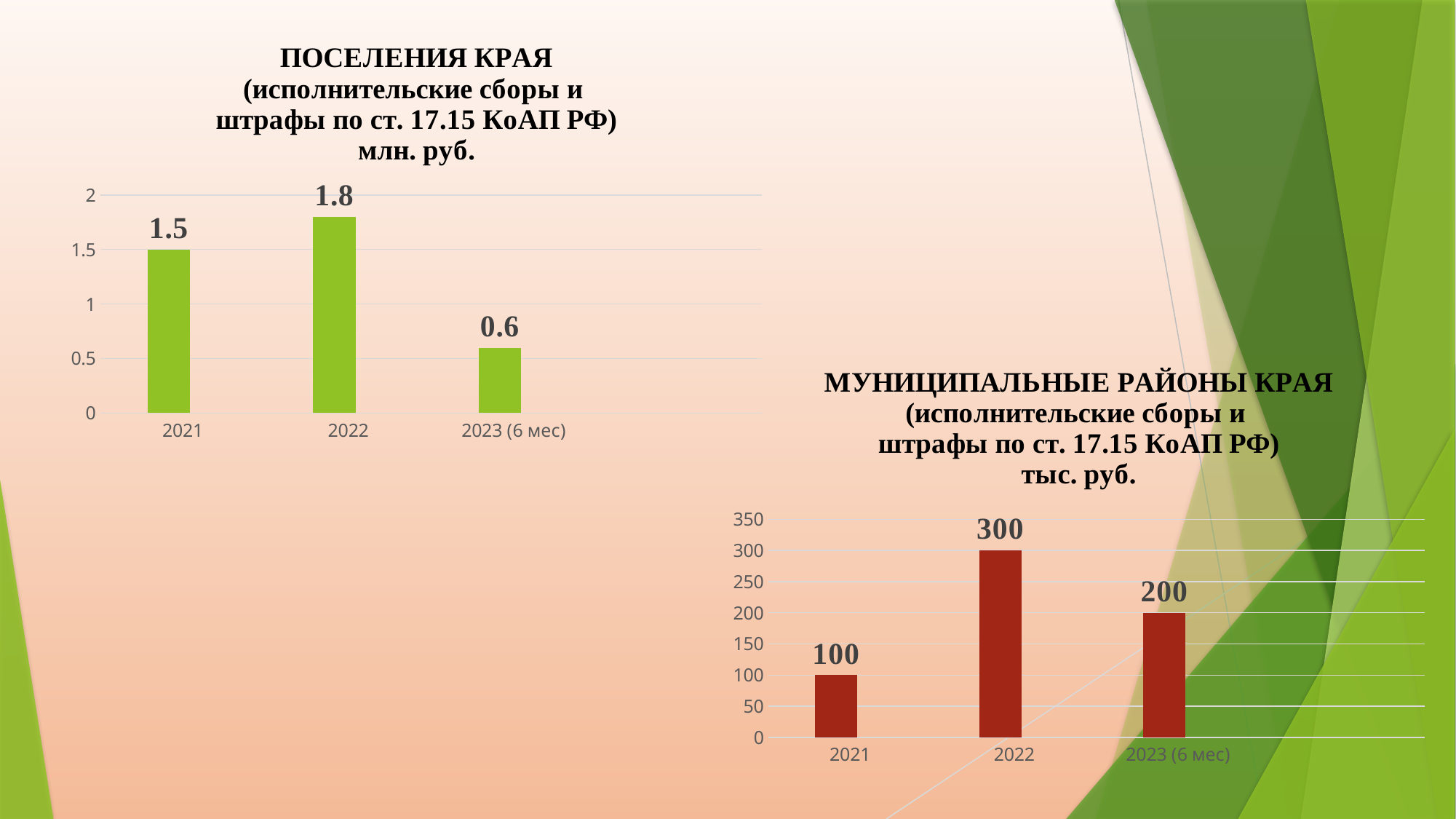
In the 'ПОСЕЛЕНИЯ КРАЯ' chart, how many bars are plotted? 3 In the 'ПОСЕЛЕНИЯ КРАЯ' chart, what is the value for 2022? 1.8 In the 'МУНИЦИПАЛЬНЫЕ РАЙОНЫ КРАЯ' chart, which is larger, the value for 2021 or for 2023 (6 мес)? 2023 (6 мес) In the 'ПОСЕЛЕНИЯ КРАЯ' chart, which category has the lowest value? 2023 (6 мес) In the 'МУНИЦИПАЛЬНЫЕ РАЙОНЫ КРАЯ' chart, which year has the highest value? 2022 In the 'МУНИЦИПАЛЬНЫЕ РАЙОНЫ КРАЯ' chart, what is the difference between the 2022 and 2023 (6 мес) values? 100 In the 'ПОСЕЛЕНИЯ КРАЯ' chart, what is the difference between the 2022 and 2021 values? 0.3 In the 'МУНИЦИПАЛЬНЫЕ РАЙОНЫ КРАЯ' chart, what is the value for 2021? 100 In the 'ПОСЕЛЕНИЯ КРАЯ' chart, which year has the highest value? 2022 In the 'МУНИЦИПАЛЬНЫЕ РАЙОНЫ КРАЯ' chart, what is the value for 2022? 300 In the 'ПОСЕЛЕНИЯ КРАЯ' chart, what is the value for 2023 (6 мес)? 0.6 What type of chart is the 'МУНИЦИПАЛЬНЫЕ РАЙОНЫ КРАЯ' chart? Bar chart